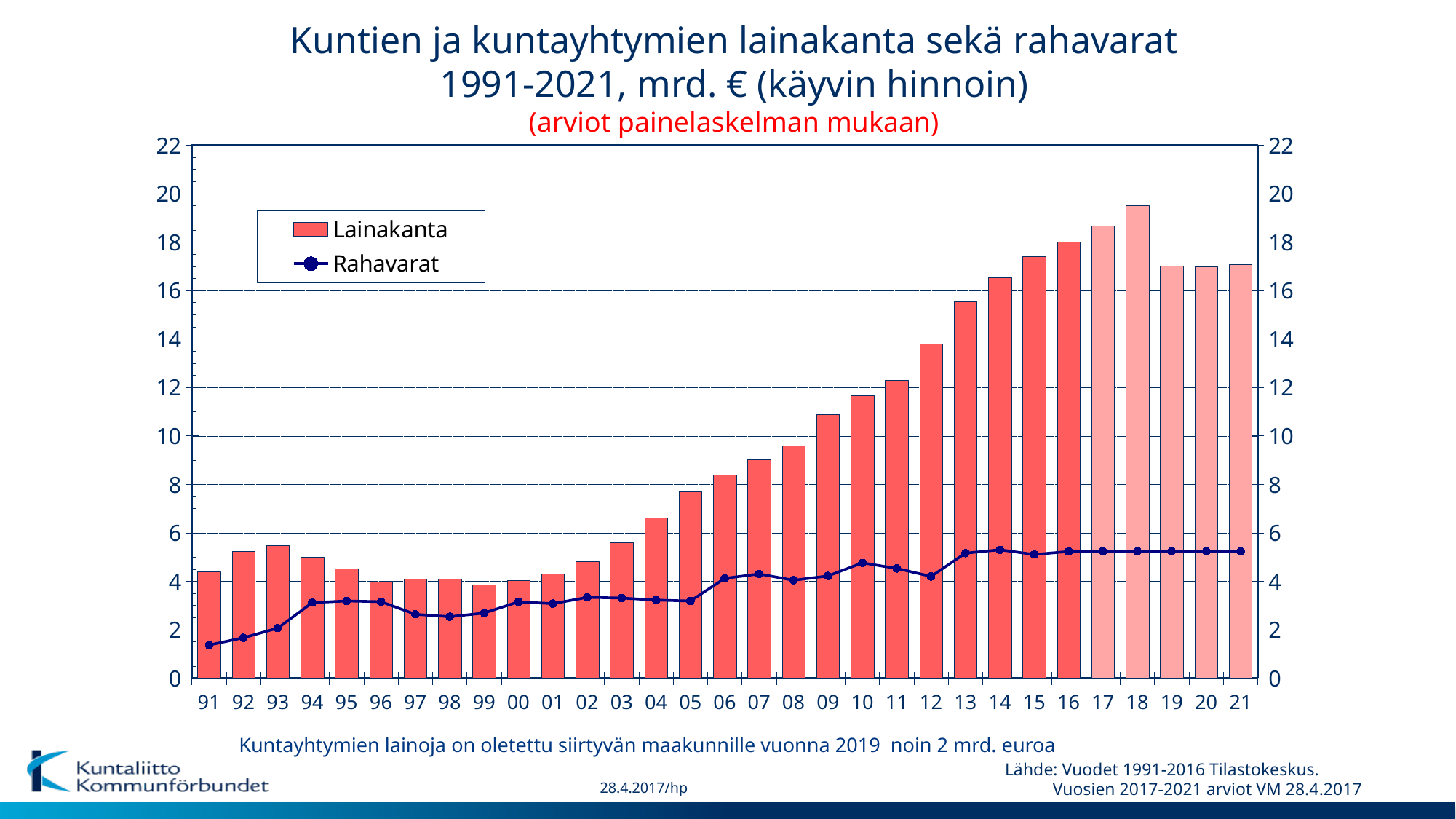
In which year is the Lainakanta bar the highest? 18 Which year has the larger Lainakanta value, 16 or 19? 16 How many years are shown on the x axis? 31 Is the Lainakanta value for 05 greater or less than 6? greater How many series does the legend list? 2 What are the two series named in the legend? Lainakanta and Rahavarat Is the Lainakanta value for 10 greater or less than 12? less In which year is the Rahavarat value the lowest? 91 Does the Lainakanta series rise or fall from 12 to 18? rise What type of chart is shown on the slide? A bar chart combined with a line chart Is the Lainakanta value for 18 greater or less than 18? greater